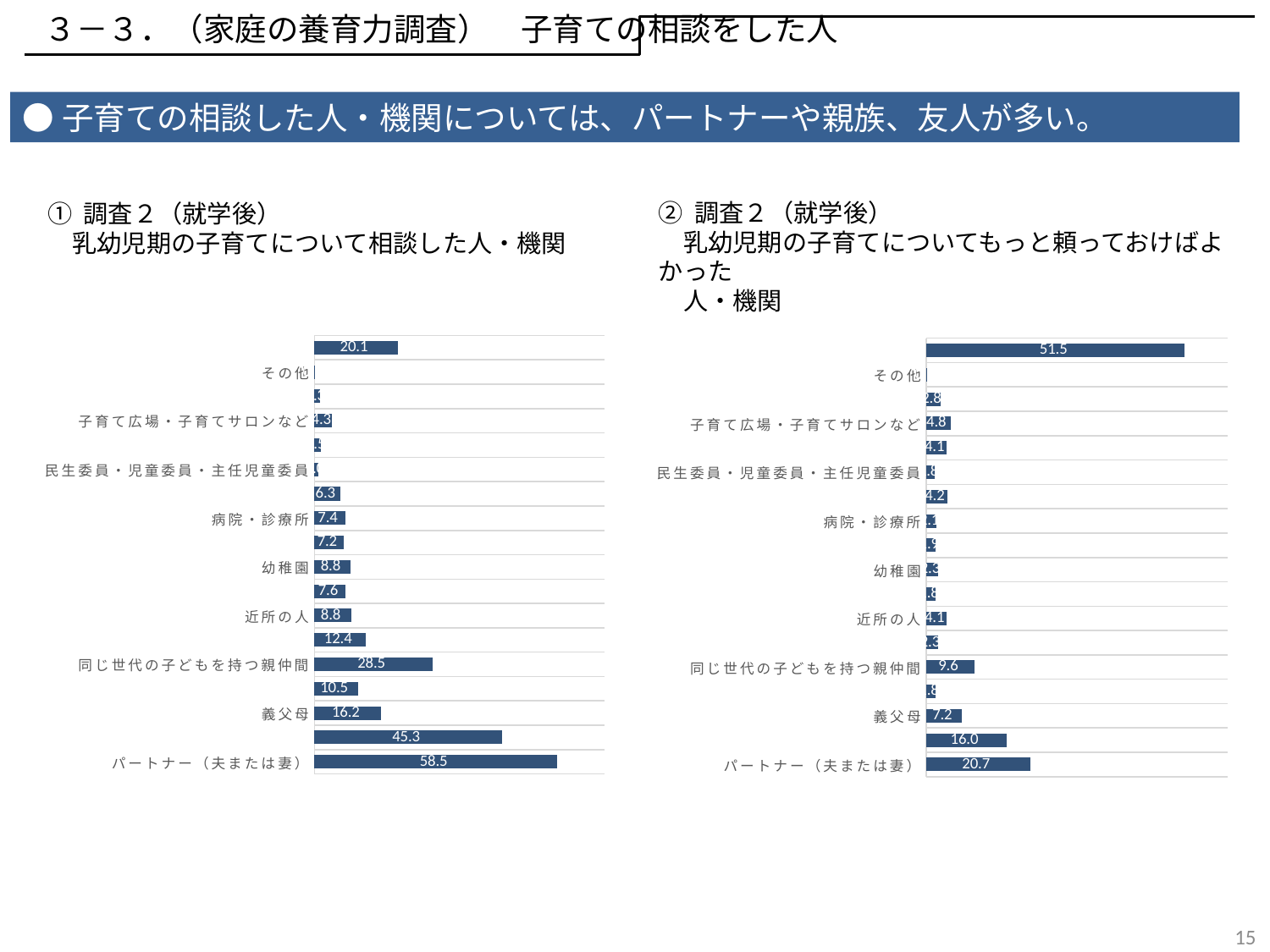
In the right chart (② もっと頼っておけばよかった人・機関), what is the value for 子育て広場・子育てサロンなど? 4.8 In the left chart (① 乳幼児期の子育てについて相談した人・機関), what is the value for パートナー（夫または妻）? 58.5 In the right chart (② もっと頼っておけばよかった人・機関), what is the difference between パートナー（夫または妻） and 義父母? 13.5 In the right chart (② もっと頼っておけばよかった人・機関), what is the value for 同じ世代の子どもを持つ親仲間? 9.6 In the left chart (① 乳幼児期の子育てについて相談した人・機関), what is the value for 義父母? 16.2 In the right chart (② もっと頼っておけばよかった人・機関), what is the value for パートナー（夫または妻）? 20.7 In the left chart (① 乳幼児期の子育てについて相談した人・機関), what is the value for 病院・診療所? 7.4 In the left chart (① 乳幼児期の子育てについて相談した人・機関), which is larger: 同じ世代の子どもを持つ親仲間 or 義父母? 同じ世代の子どもを持つ親仲間 In the left chart (① 乳幼児期の子育てについて相談した人・機関), which labeled category has the highest value? パートナー（夫または妻） In the left chart (① 乳幼児期の子育てについて相談した人・機関), what is the value for 同じ世代の子どもを持つ親仲間? 28.5 What type of chart is used on this slide? Bar chart In the left chart (① 乳幼児期の子育てについて相談した人・機関), what is the difference between パートナー（夫または妻） and 義父母? 42.3